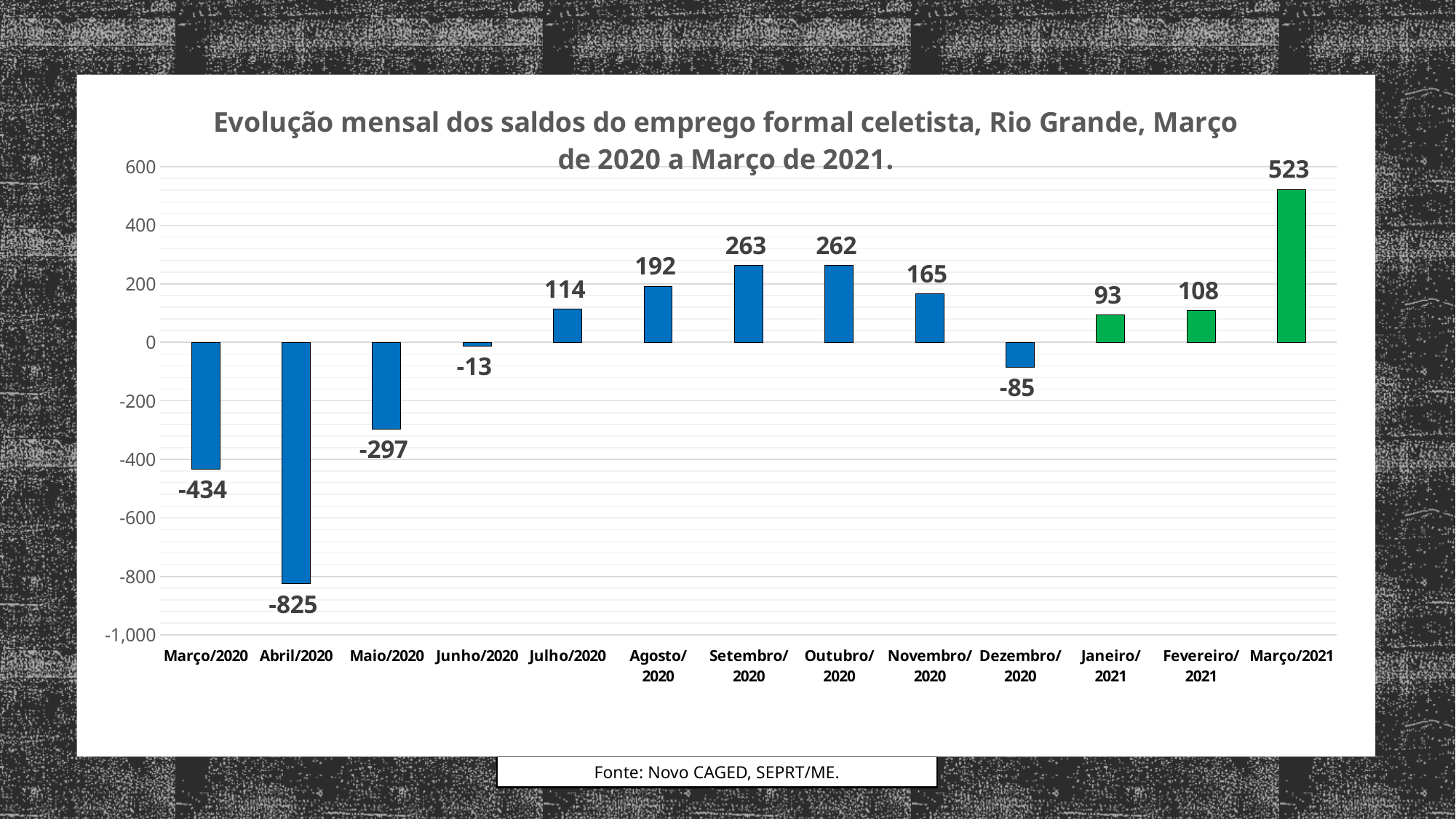
How many months are shown on the x axis? 13 What is the difference between the values for Março/2021 and Fevereiro/2021? 415 What is the value for Março/2021? 523 Which month has the highest value? Março/2021 Which month has the lowest value? Abril/2020 How many months have a negative value? 5 What kind of chart is this? Bar chart Which is larger, the value for Agosto/2020 or the value for Novembro/2020? Agosto/2020 What is the value for Setembro/2020? 263 What is the value for Abril/2020? -825 Is the value for Maio/2020 greater or less than -200? less What is the source cited below the chart? Novo CAGED, SEPRT/ME.